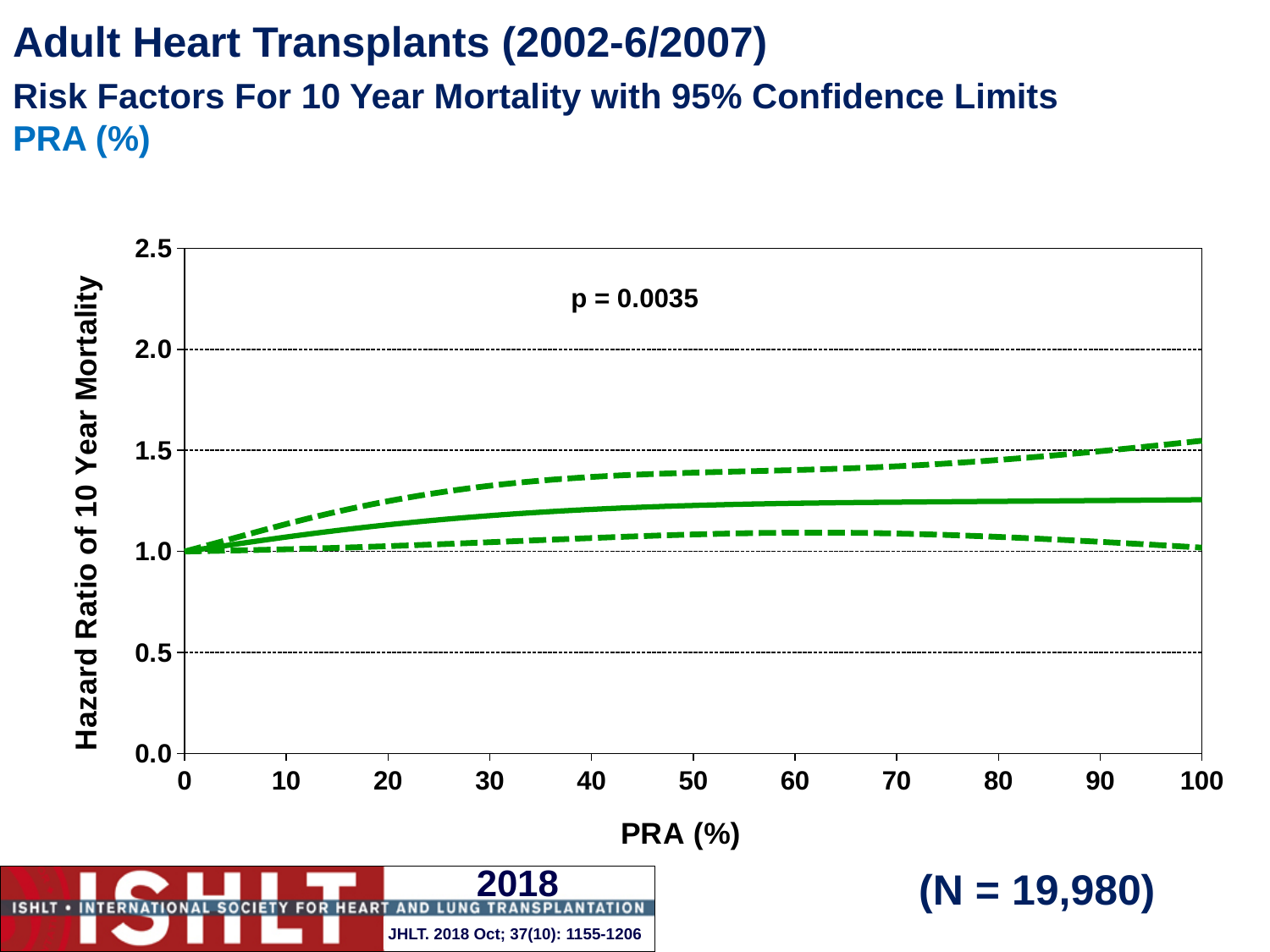
What is the sample size (N) shown on the slide? N = 19,980 Is the hazard ratio of the solid line at PRA 50% greater or less than 1.0? greater Does the solid hazard ratio line rise or fall as PRA increases from 0 to 100? rises What kind of chart is shown on the slide? line chart Is the hazard ratio of the solid line at PRA 100% greater or less than 1.5? less Is the upper confidence limit (upper dashed line) at PRA 100% greater or less than 2.0? less What is the p-value printed on the chart? p = 0.0035 What is the label of the x axis? PRA (%) What is the hazard ratio of the solid line at PRA 0%? 1.0 How many lines are plotted on the chart? 3 What is the label of the y axis? Hazard Ratio of 10 Year Mortality